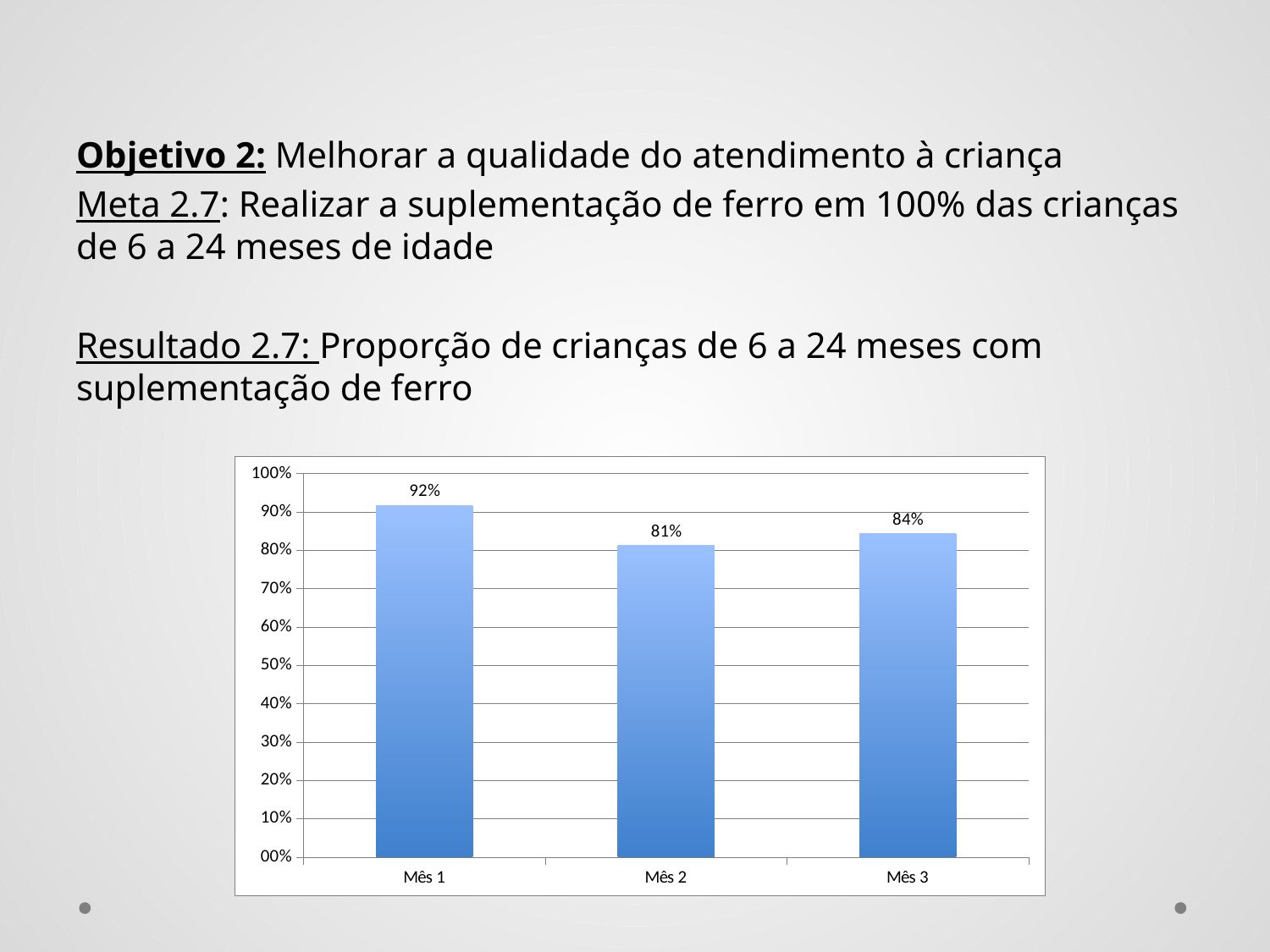
Which is larger, the value for Mês 2 or Mês 3? Mês 3 What is the value for Mês 1? 92% Does the value rise or fall from Mês 1 to Mês 2? fall What is the value for Mês 2? 81% Which month has the highest value? Mês 1 How many months are shown on the chart? 3 What kind of chart is shown on the slide? bar chart What is the value for Mês 3? 84% What is the difference between the values for Mês 1 and Mês 2? 11% Which month has the lowest value? Mês 2 Is the value for Mês 1 greater or less than 90%? greater What is the difference between the values for Mês 3 and Mês 2? 3%